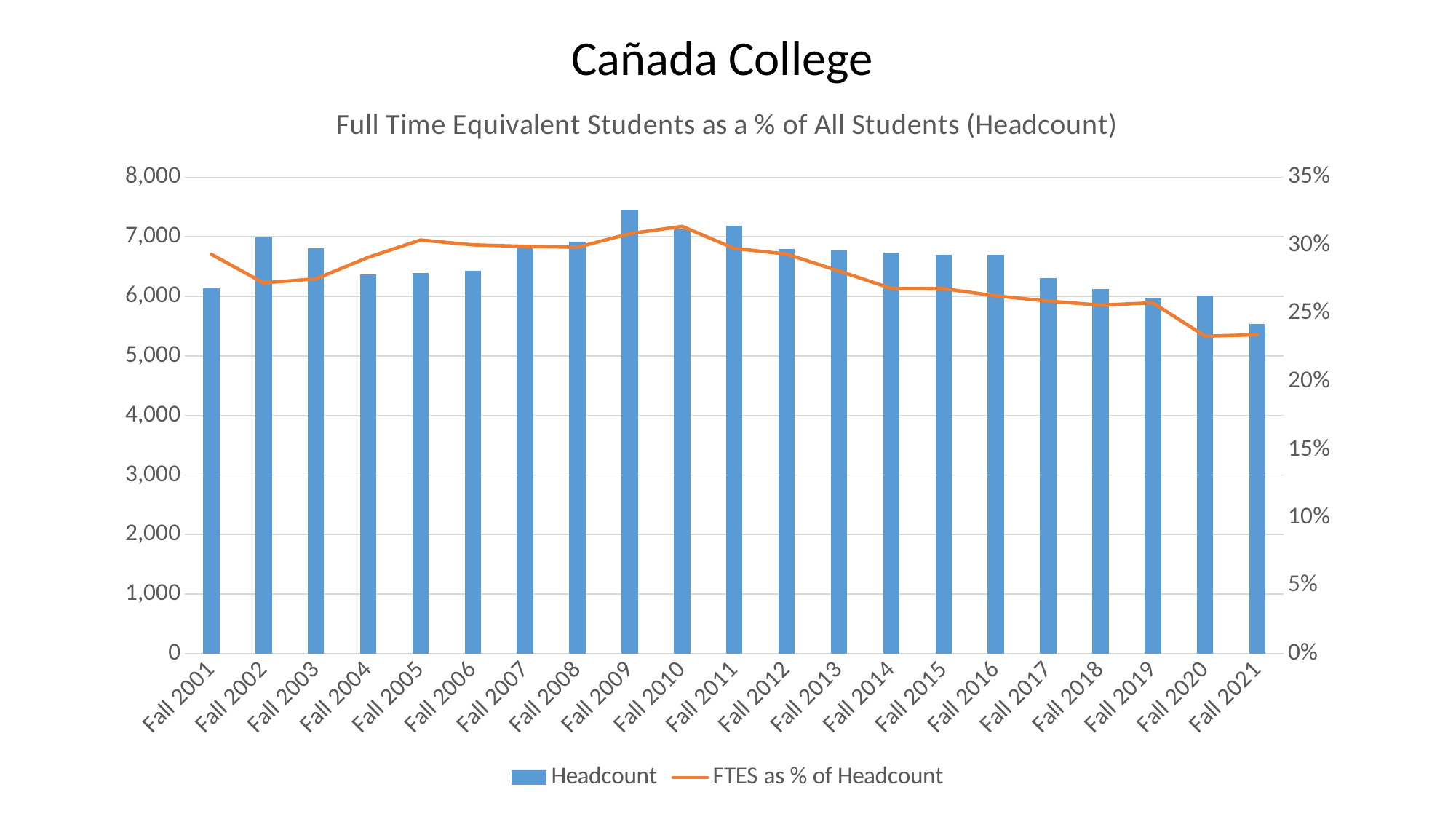
Is the Headcount for Fall 2021 greater or less than 6,000? less Does FTES as % of Headcount rise or fall from Fall 2010 to Fall 2021? fall Is FTES as % of Headcount for Fall 2021 greater or less than 25%? less Which has the larger Headcount, Fall 2002 or Fall 2004? Fall 2002 What kind of chart is shown on the slide? A combined bar and line chart In which Fall term is FTES as % of Headcount highest? Fall 2010 Which Fall term has the lowest Headcount? Fall 2021 Which Fall term has the highest Headcount? Fall 2009 How many Fall terms are shown on the x axis? 21 Is the Headcount for Fall 2009 greater or less than 7,000? greater How many series does the legend list? 2